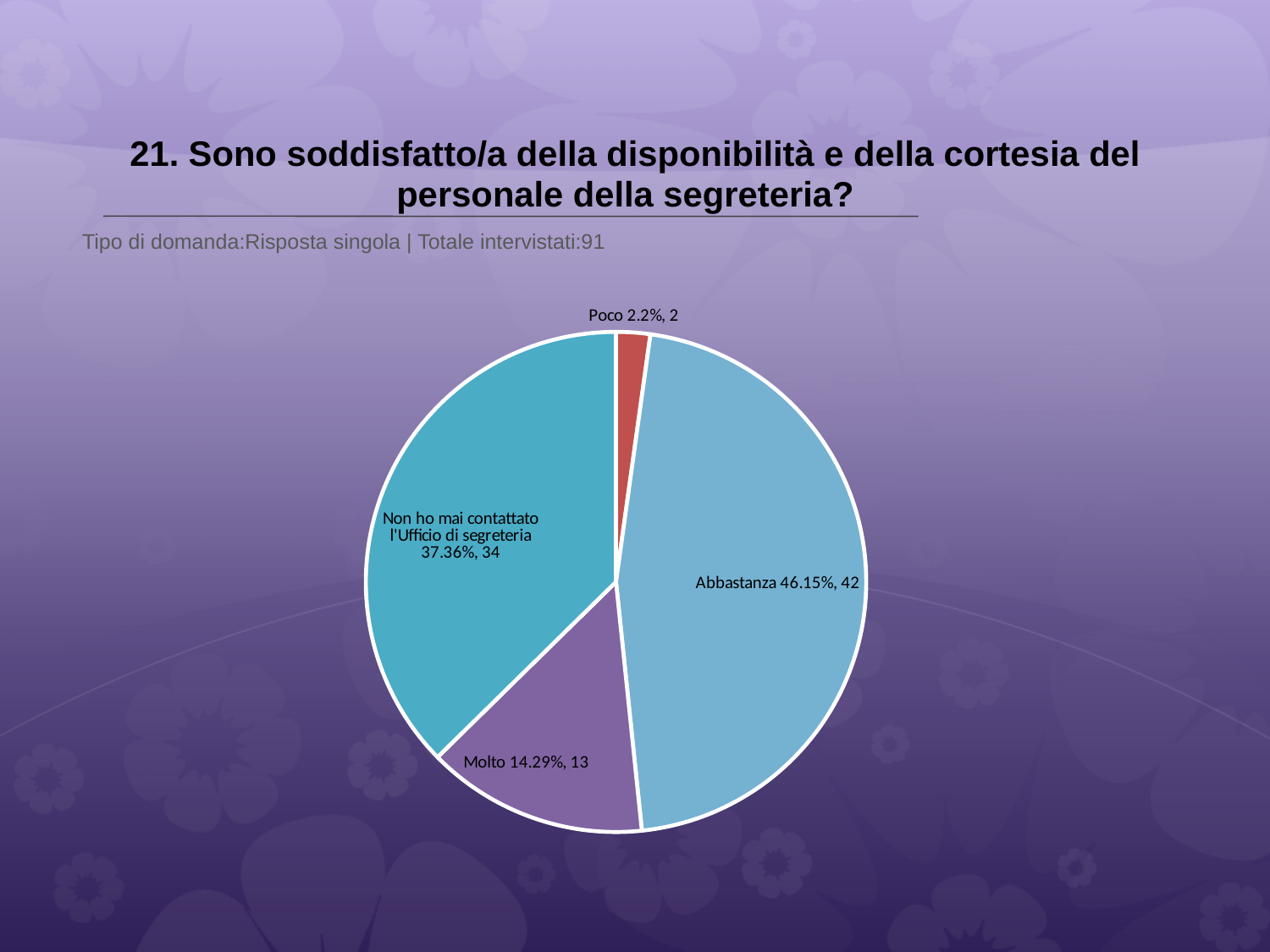
Which category has the smallest slice of the pie? Poco What percentage share does the 'Abbastanza' slice represent? 46.15% How many respondents answered 'Molto'? 13 What type of chart is shown on the slide? pie chart What is the difference in respondent count between 'Abbastanza' and 'Molto'? 29 How many respondents answered 'Non ho mai contattato l'Ufficio di segreteria'? 34 What colour is the 'Poco' slice? red What is the total number of respondents shown in the subtitle of the slide? 91 Which category has the largest slice of the pie? Abbastanza Which has more respondents, 'Molto' or 'Non ho mai contattato l'Ufficio di segreteria'? Non ho mai contattato l'Ufficio di segreteria How many slices does the pie chart have? 4 What percentage share does the 'Poco' slice represent? 2.2%